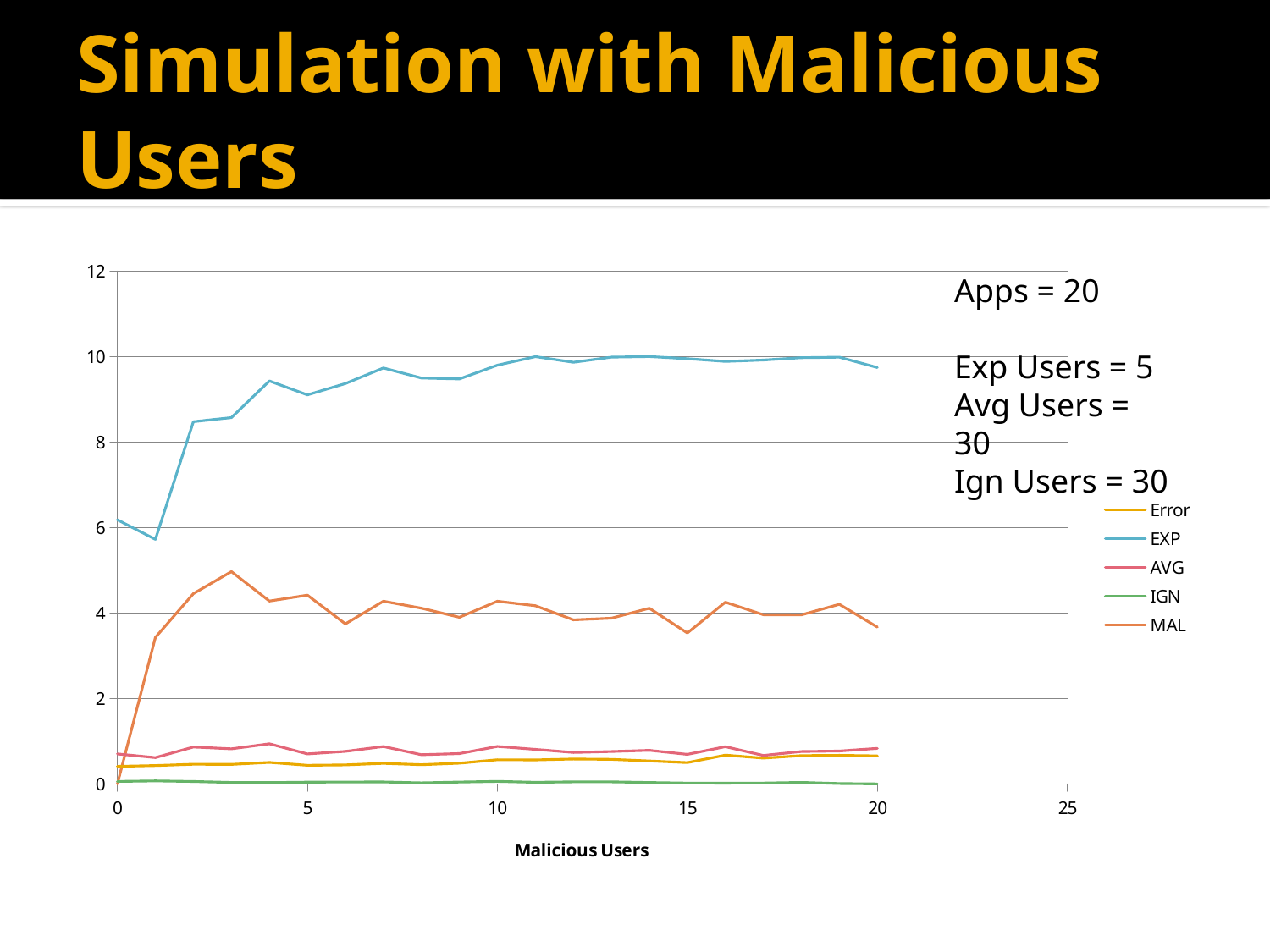
Which series has the lowest values across the chart? IGN Is the value of the EXP series at 1 malicious user greater or less than 8? less Does the EXP series rise or fall between 1 and 4 malicious users? rise Is the value of the MAL series at 0 malicious users greater or less than 2? less What kind of chart is shown on the slide? line chart Is the value of the MAL series at 3 malicious users greater or less than 4? greater At 15 malicious users, which series has the larger value, MAL or AVG? MAL How many series does the legend list? 5 Which series has the highest values across the chart? EXP What is the title of the x axis? Malicious Users What value of Apps is stated in the text on the chart? 20